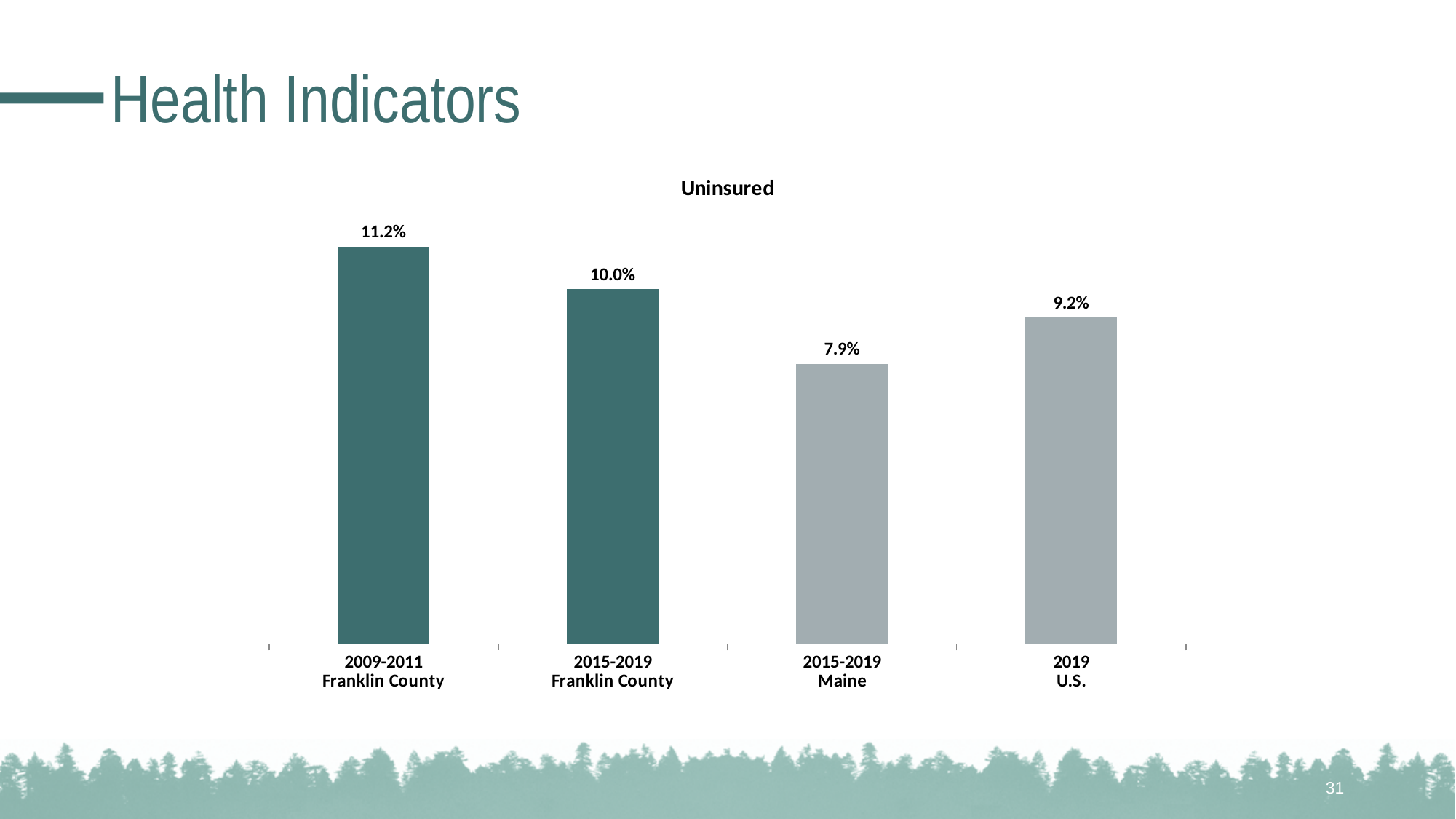
What is the uninsured rate for Maine in 2015-2019? 7.9% What is the uninsured rate for Franklin County in 2009-2011? 11.2% What type of chart is shown on the slide? Bar chart What is the uninsured rate for the U.S. in 2019? 9.2% What is the difference between the Franklin County uninsured rate in 2009-2011 and in 2015-2019? 1.2% Which category has the highest uninsured rate? 2009-2011 Franklin County How many bars are shown in the chart? 4 Which is larger, the 2015-2019 Franklin County uninsured rate or the 2019 U.S. uninsured rate? 2015-2019 Franklin County What is the uninsured rate for Franklin County in 2015-2019? 10.0% What is the title of the chart? Uninsured Which category has the lowest uninsured rate? 2015-2019 Maine What is the difference between the 2019 U.S. uninsured rate and the 2015-2019 Maine uninsured rate? 1.3%